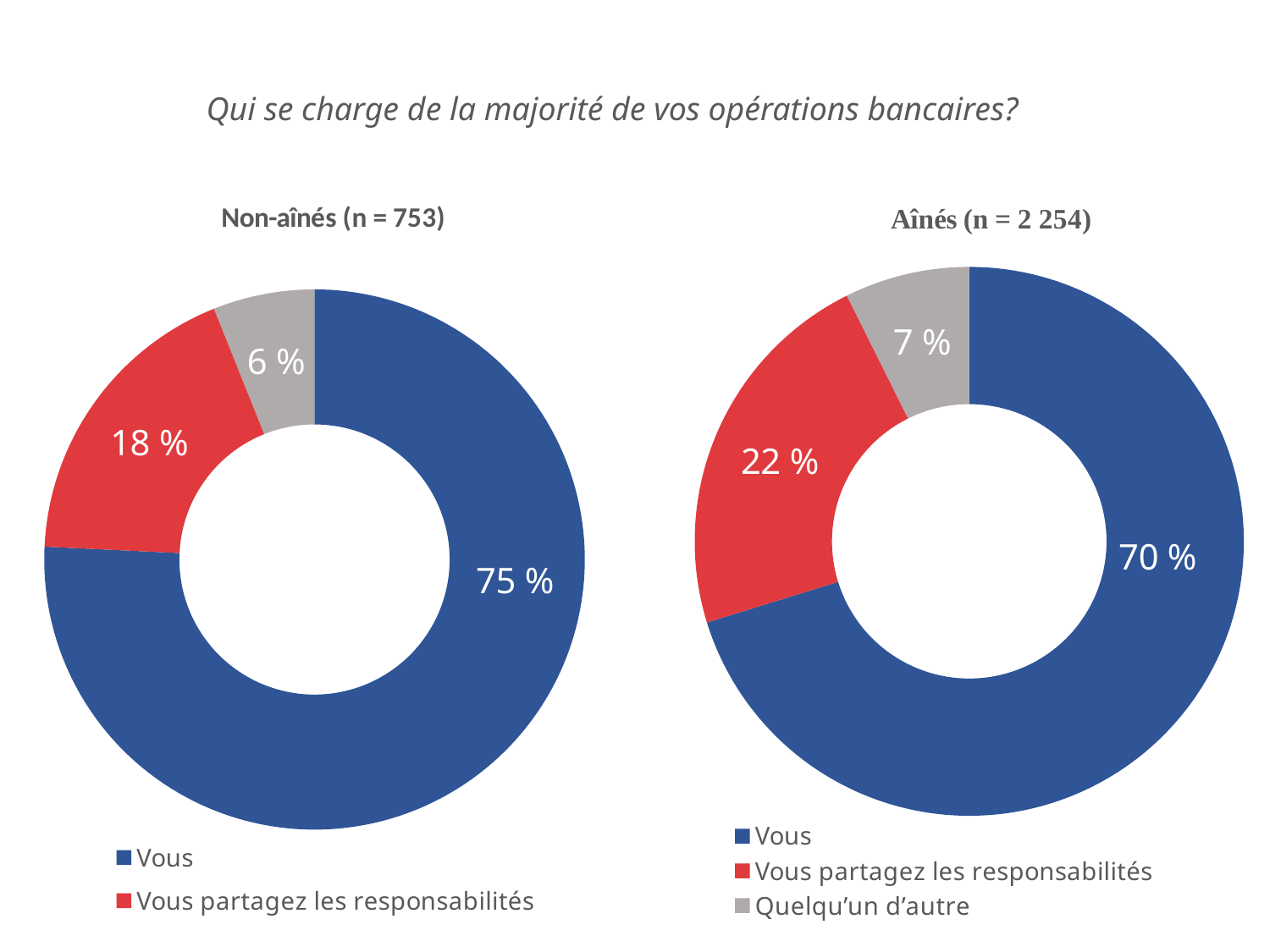
In the Aînés (n = 2 254) chart, which category has the largest share? Vous What is the question shown as the title at the top of the slide? Qui se charge de la majorité de vos opérations bancaires? What type of chart is used on this slide? Doughnut (pie) chart How many slices does the Non-aînés (n = 753) chart have? 3 What is the difference between the "Vous" share in the Non-aînés chart and the "Vous" share in the Aînés chart? 5 % In the Aînés (n = 2 254) chart, which category has the smallest share? Quelqu'un d'autre In the Aînés (n = 2 254) chart, what percentage is shown for "Vous partagez les responsabilités"? 22 % Which chart shows a larger share for "Vous partagez les responsabilités", Non-aînés or Aînés? Aînés In the Non-aînés (n = 753) chart, what percentage is shown for "Vous partagez les responsabilités"? 18 % In the Non-aînés (n = 753) chart, what percentage is shown for "Vous"? 75 % In the Aînés (n = 2 254) chart, what percentage is shown for "Quelqu'un d'autre"? 7 % How many legend entries does the Aînés (n = 2 254) chart list? 3